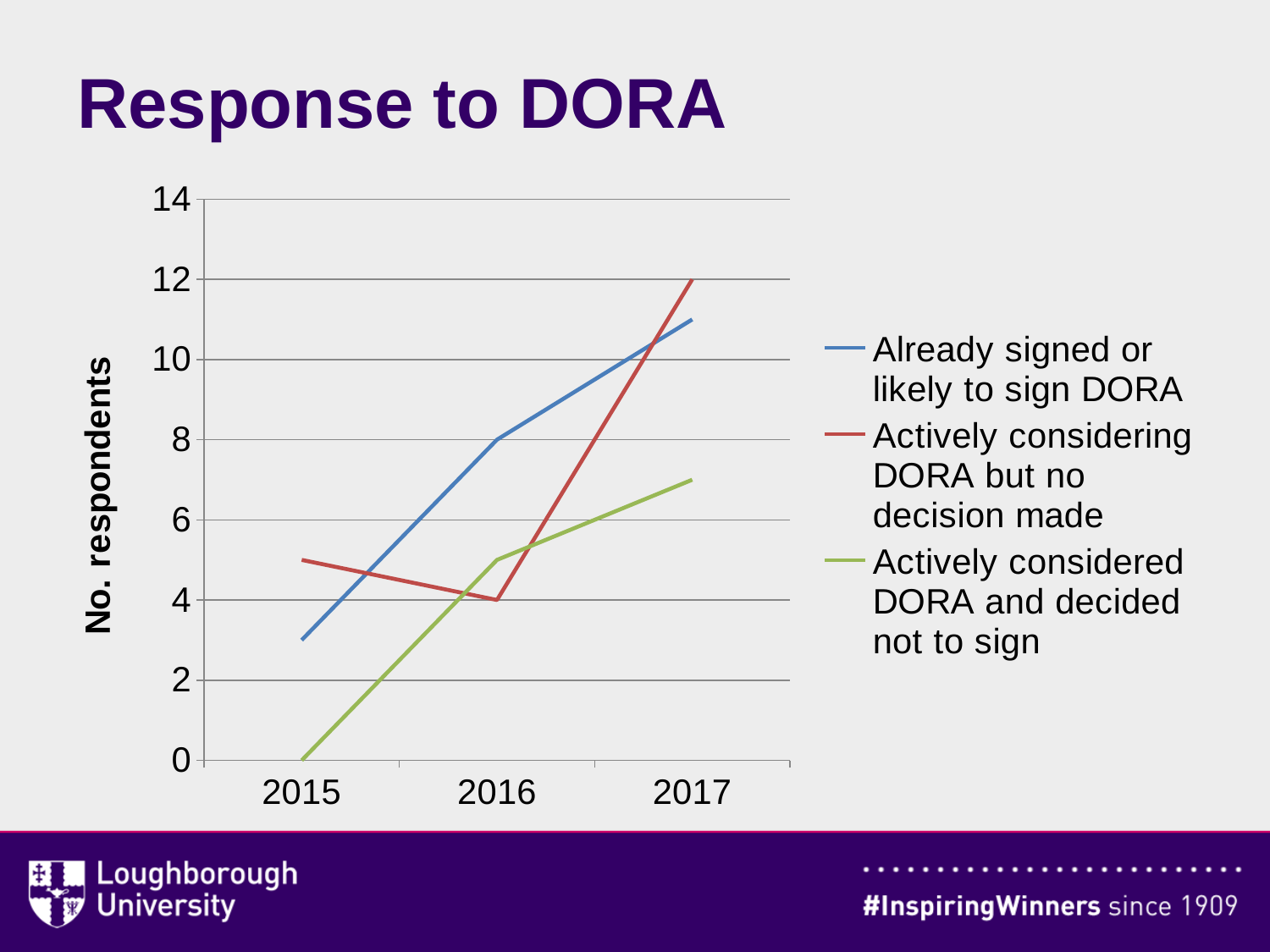
What is the value for 'Already signed or likely to sign DORA' in 2016? 8 What is the label on the vertical axis? No. respondents Does the 'Already signed or likely to sign DORA' series rise or fall from 2015 to 2017? rise What kind of chart is shown on the slide? line chart Is the value for 'Actively considered DORA and decided not to sign' in 2017 greater or less than 6? greater What is the value for 'Actively considered DORA and decided not to sign' in 2015? 0 What is the value for 'Actively considering DORA but no decision made' in 2017? 12 What is the value for 'Actively considering DORA but no decision made' in 2016? 4 Which series has the lowest value in 2015? Actively considered DORA and decided not to sign How many years are plotted along the x axis? 3 How many series does the legend list? 3 Is the value for 'Already signed or likely to sign DORA' in 2015 greater or less than 4? less